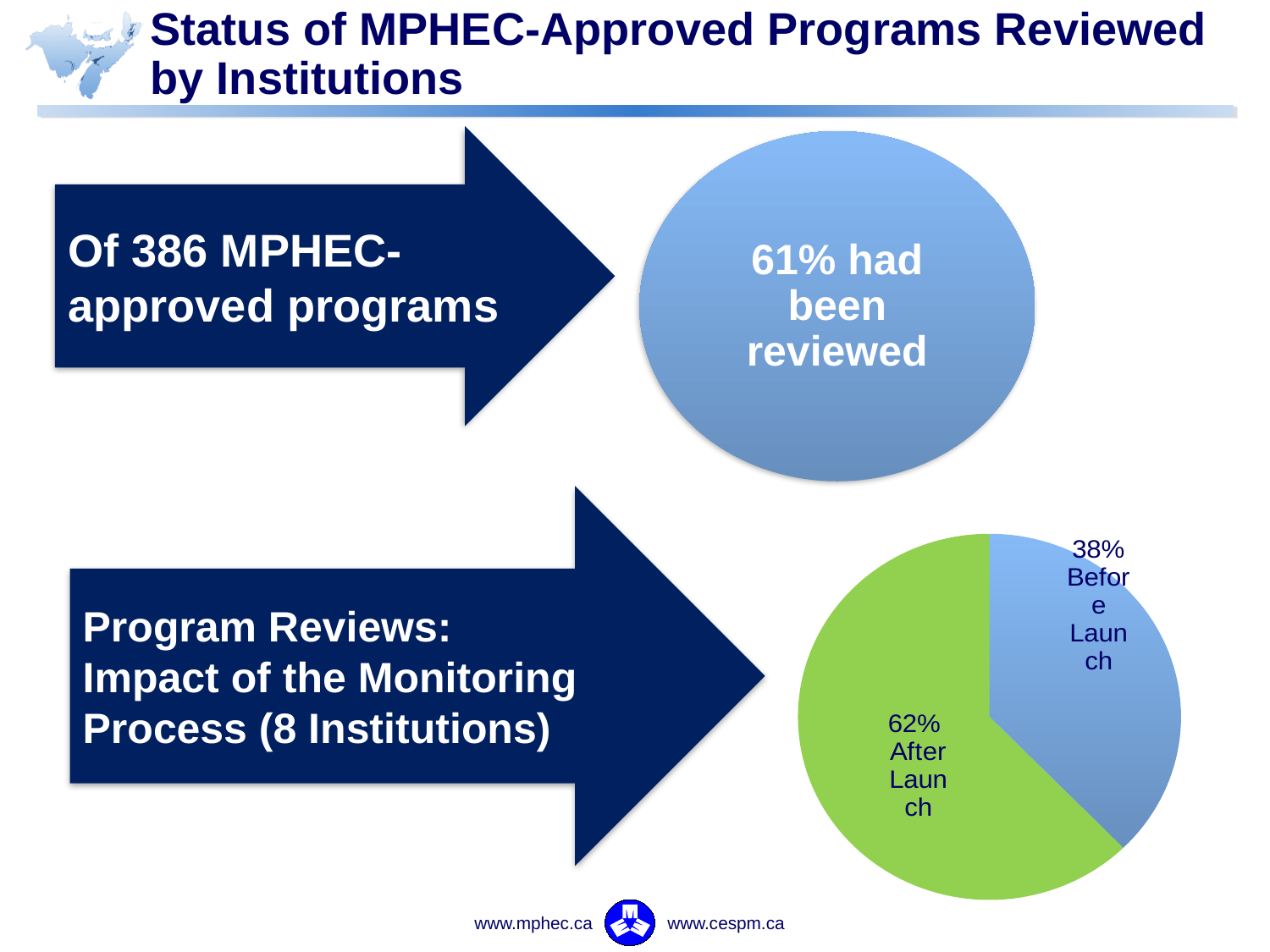
Which slice of the pie chart is the largest? After Launch Is the After Launch share in the pie chart greater or less than 50%? greater What share of the pie chart is labelled Before Launch? 38% What is the difference in percentage points between the After Launch and Before Launch slices of the pie chart? 24 How many slices does the pie chart have? 2 In the pie chart, which is larger: Before Launch or After Launch? After Launch What colour is the Before Launch slice of the pie chart? blue What share of the pie chart is labelled After Launch? 62% What kind of chart is shown at the bottom right of the slide? pie chart What colour is the After Launch slice of the pie chart? green Which slice of the pie chart is the smallest? Before Launch